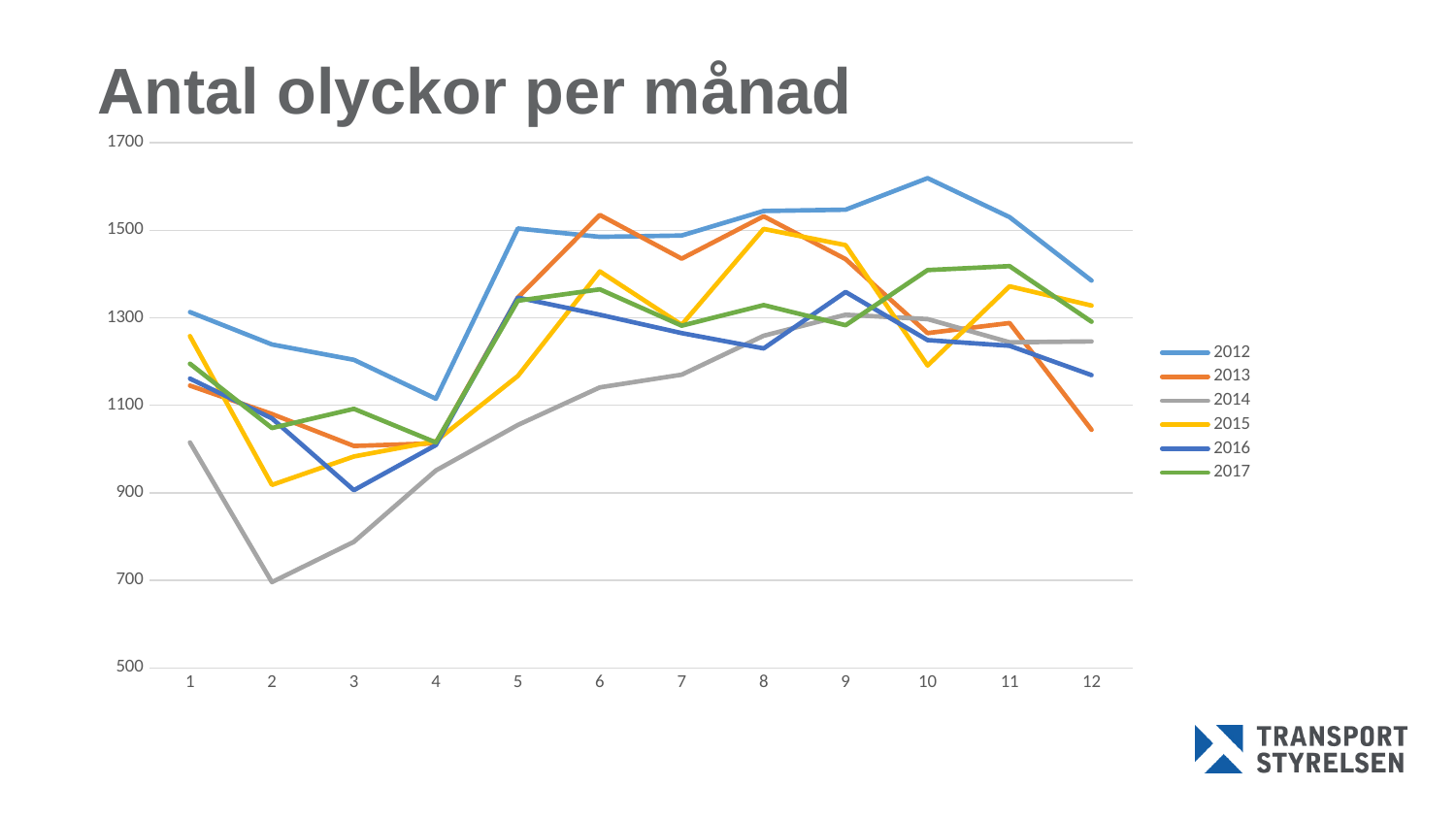
How many points along the x axis does each series have? 12 At month 1, which is larger, the value for 2012 or the value for 2014? 2012 Is the value for 2013 at month 12 greater or less than 1100? less Is the value for 2012 at month 10 greater or less than 1500? greater Which series is lowest at month 12? 2013 What kind of chart is shown on the slide? line chart Which series is highest at month 10? 2012 Does the 2014 series rise or fall from month 2 to month 10? rise Is the value for 2014 at month 3 greater or less than 900? less What is the title of the chart? Antal olyckor per månad Which series is lowest at month 2? 2014 How many series does the legend list? 6